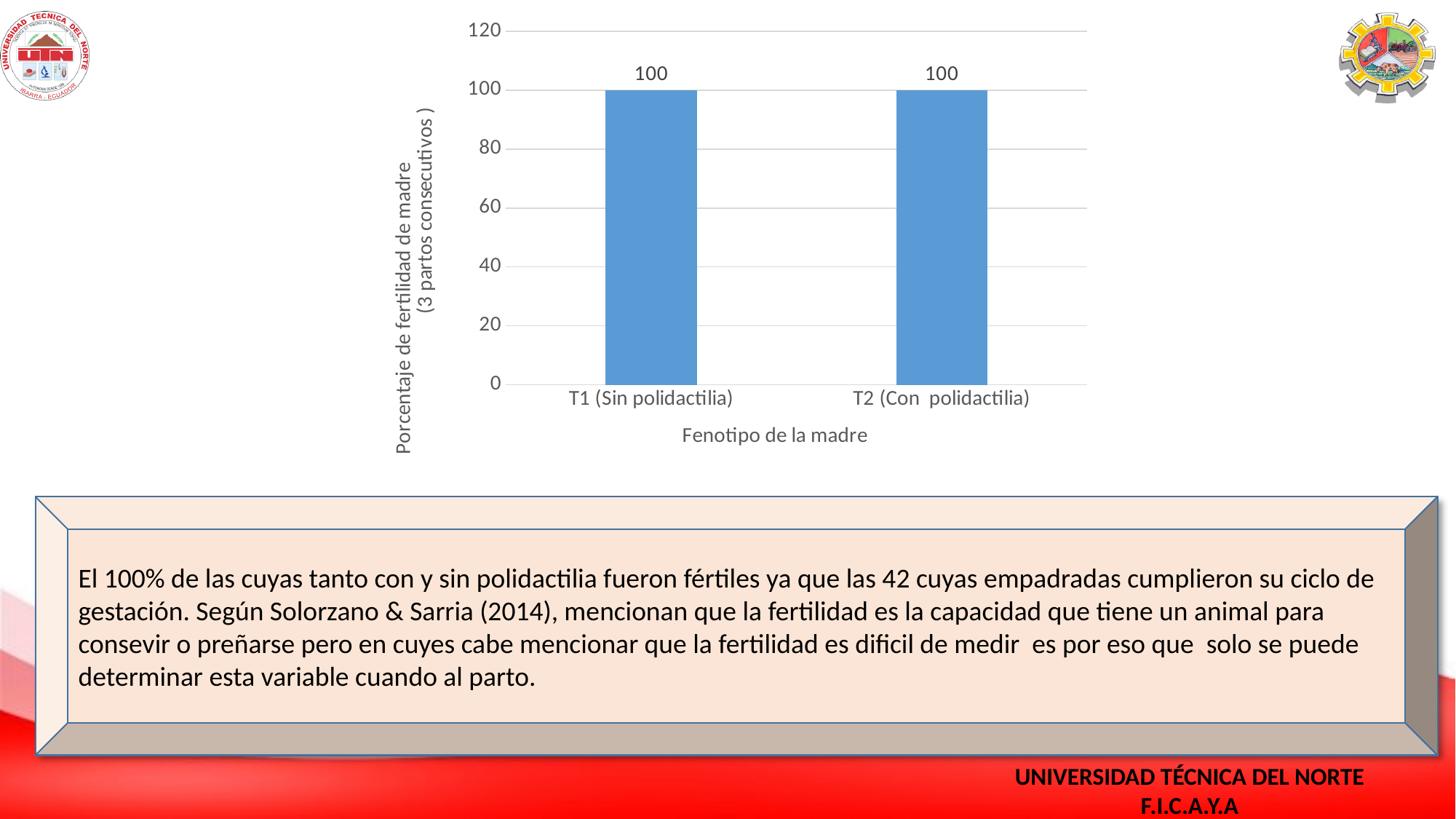
What is the highest value shown on the y axis? 120 Is the value for T2 (Con polidactilia) greater or less than 120? less What is the difference between the values for T1 (Sin polidactilia) and T2 (Con polidactilia)? 0 Is the value for T1 (Sin polidactilia) greater or less than 80? greater Do the values rise, fall or stay the same from T1 (Sin polidactilia) to T2 (Con polidactilia)? Stay the same What is the label of the y axis? Porcentaje de fertilidad de madre (3 partos consecutivos ) What is the label of the x axis? Fenotipo de la madre What is the value for T2 (Con polidactilia)? 100 How many categories are shown on the x axis? 2 What is the value for T1 (Sin polidactilia)? 100 What kind of chart is shown on the slide? Bar chart